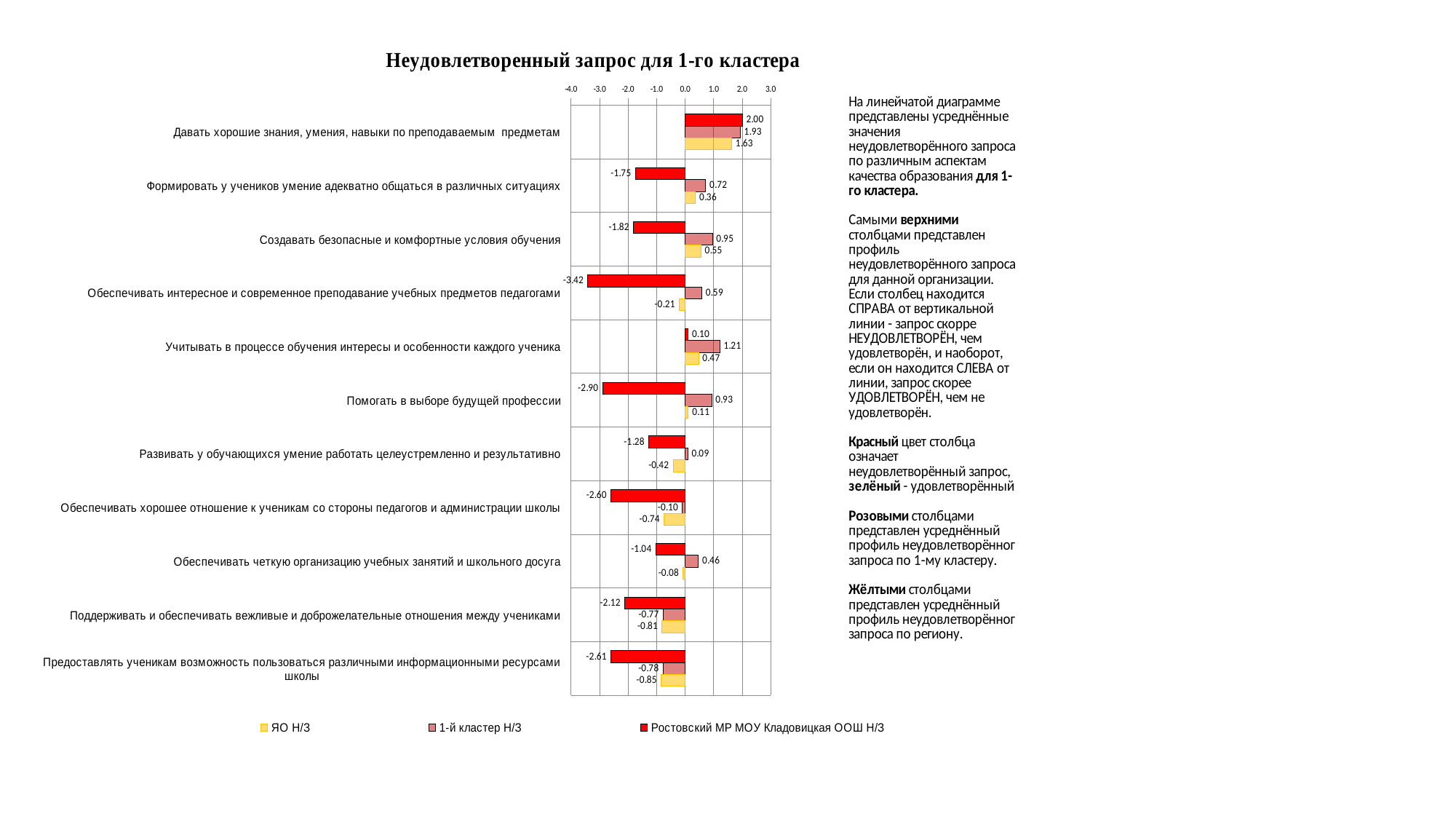
What is the value for the series "1-й кластер Н/З" for the category "Учитывать в процессе обучения интересы и особенности каждого ученика"? 1.21 How many categories are shown on the chart? 11 What is the difference between the "1-й кластер Н/З" value and the "ЯО Н/З" value for the category "Создавать безопасные и комфортные условия обучения"? 0.40 For the category "Формировать у учеников умение адекватно общаться в различных ситуациях", which series has the larger value: "1-й кластер Н/З" or "ЯО Н/З"? 1-й кластер Н/З What is the value for the series "ЯО Н/З" for the category "Помогать в выборе будущей профессии"? 0.11 Which category has the highest value for the series "ЯО Н/З"? Давать хорошие знания, умения, навыки по преподаваемым предметам How many series does the legend list? 3 What is the value for the series "Ростовский МР МОУ Кладовицкая ООШ Н/З" for the category "Давать хорошие знания, умения, навыки по преподаваемым предметам"? 2.00 What is the value for the series "Ростовский МР МОУ Кладовицкая ООШ Н/З" for the category "Обеспечивать интересное и современное преподавание учебных предметов педагогами"? -3.42 What kind of chart is shown on the slide? Bar chart What is the title of the chart? Неудовлетворенный запрос для 1-го кластера Which category has the lowest value for the series "Ростовский МР МОУ Кладовицкая ООШ Н/З"? Обеспечивать интересное и современное преподавание учебных предметов педагогами